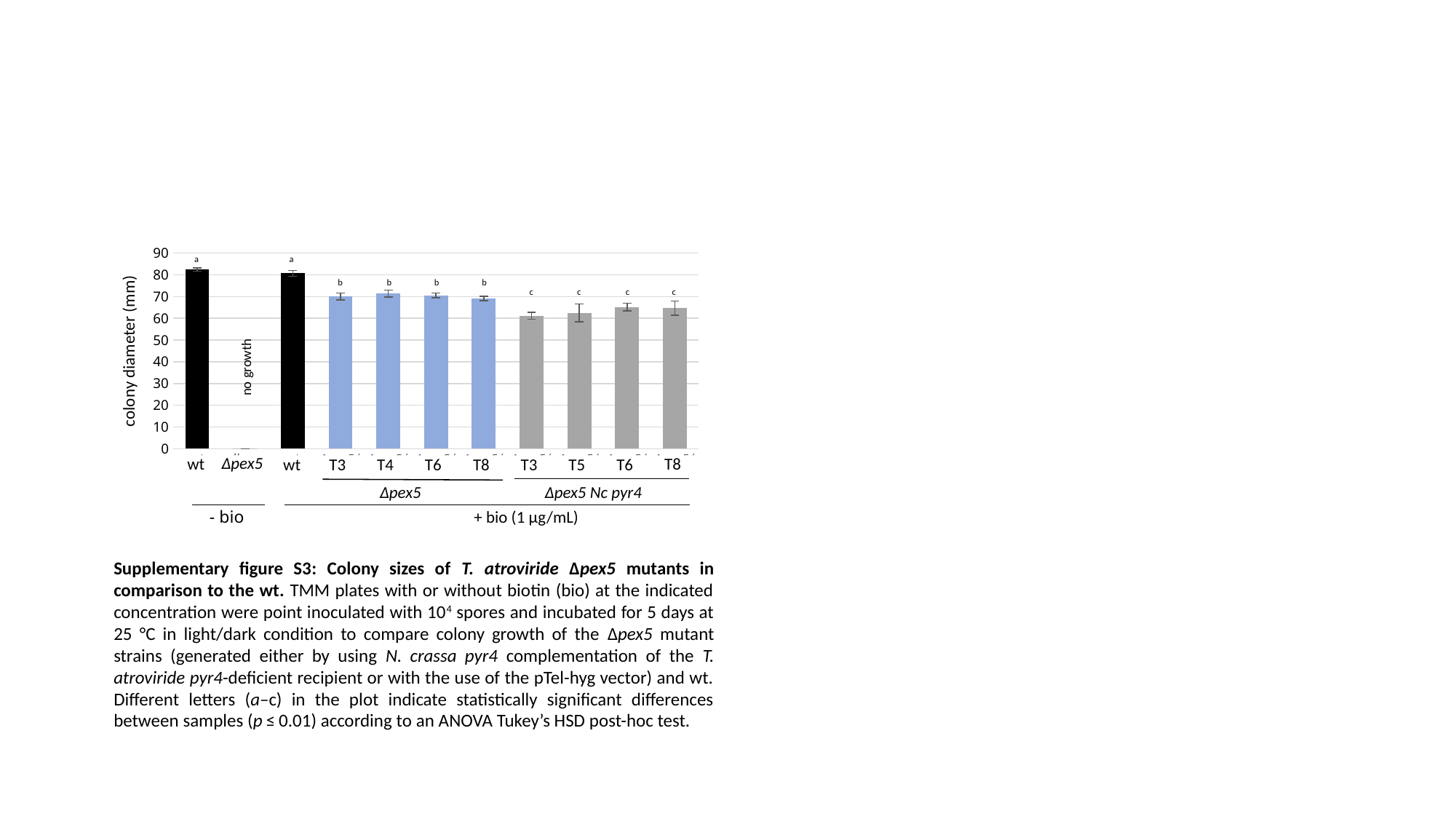
Which is larger: the value for Δpex5 T4 under + bio or the value for Δpex5 Nc pyr4 T5? Δpex5 T4 What colour are the bars for the Δpex5 Nc pyr4 strains? grey Is the value for Δpex5 Nc pyr4 T3 greater or less than 70? less Is the value for Δpex5 Nc pyr4 T6 greater or less than 60? greater What is the label of the y-axis of the chart? colony diameter (mm) How many bars (categories) are plotted in the chart, including the one marked 'no growth'? 11 Is the value for wt under - bio greater or less than 70? greater What kind of chart is shown on the slide? bar chart Which is larger: the value for wt under - bio or the value for Δpex5 Nc pyr4 T3? wt under - bio Which category in the chart is marked 'no growth'? Δpex5 under - bio